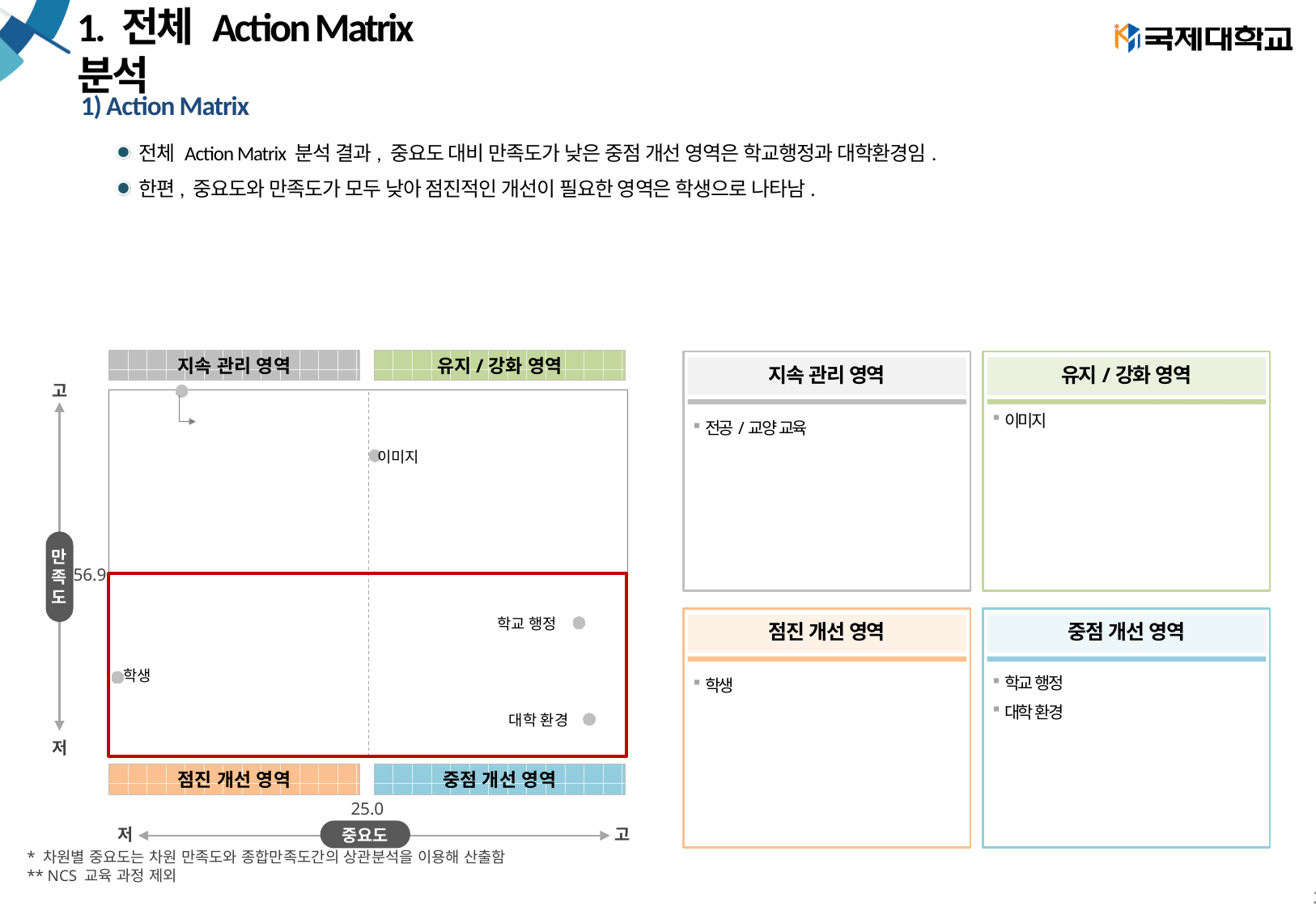
In the Action Matrix chart, is the 중요도 value for 학생 greater or less than 25.0? less In the Action Matrix chart, which has the higher 만족도, 학교 행정 or 대학 환경? 학교 행정 In the Action Matrix chart, which quadrant does the point 학생 fall in? 점진 개선 영역 In the Action Matrix chart, what value marks the vertical dividing line on the 중요도 axis? 25.0 What kind of chart is the Action Matrix on the left of the slide? scatter chart In the Action Matrix chart, is the 만족도 value for 대학 환경 greater or less than 56.9? less In the Action Matrix chart, is the 만족도 value for 이미지 greater or less than 56.9? greater In the Action Matrix chart, what is the label of the vertical axis? 만족도 In the Action Matrix chart, which has the higher 중요도, 학생 or 학교 행정? 학교 행정 In the Action Matrix chart, what value marks the horizontal dividing line on the 만족도 axis? 56.9 In the Action Matrix chart, which labeled point has the lowest 만족도? 대학 환경 In the Action Matrix chart, which labeled point has the lowest 중요도? 학생